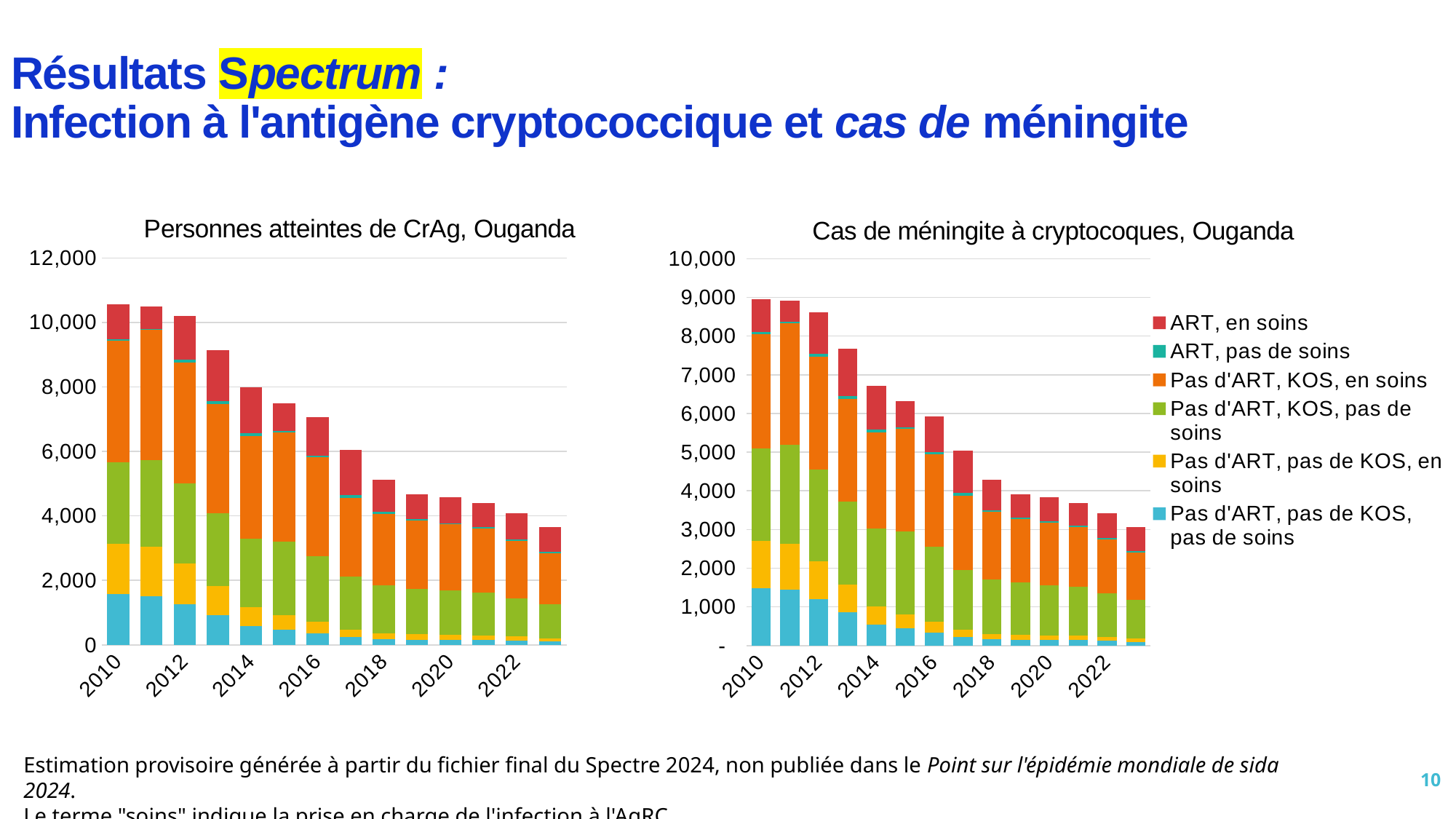
Which legend entry is shown in red on the charts? ART, en soins In the 'Personnes atteintes de CrAg, Ouganda' chart, do the total bar heights rise or fall from 2010 to 2023? fall How many years are plotted on the 'Cas de méningite à cryptocoques, Ouganda' chart? 14 What kind of chart is 'Personnes atteintes de CrAg, Ouganda'? stacked bar chart In the 'Cas de méningite à cryptocoques, Ouganda' chart, which total is larger, 2010 or 2020? 2010 In the 'Cas de méningite à cryptocoques, Ouganda' chart, is the total for 2022 greater or less than 4,000? less In the 'Personnes atteintes de CrAg, Ouganda' chart, is the total for 2023 greater or less than 4,000? less In the 'Personnes atteintes de CrAg, Ouganda' chart, is the total for 2010 greater or less than 10,000? greater In the 'Personnes atteintes de CrAg, Ouganda' chart, which year has the lowest total? 2023 How many series does the legend list for the charts on this slide? 6 In the 'Cas de méningite à cryptocoques, Ouganda' chart, which year has the highest total? 2010